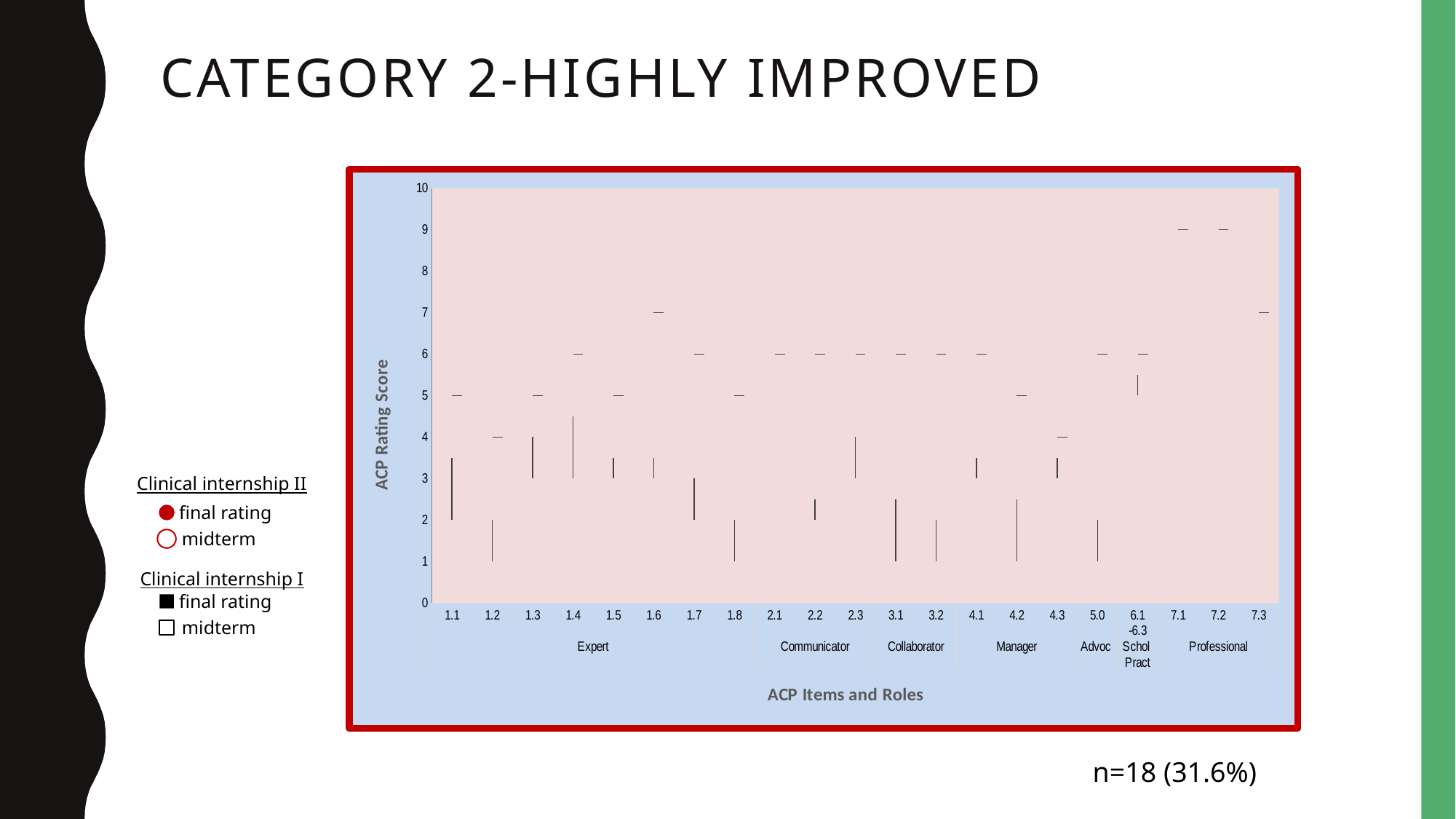
How many role groups (such as Expert, Communicator) are labelled beneath the x axis of the chart? 7 Is the lowest mark plotted for item 3.1 greater or less than 3? less Which role group covers the most ACP items on the x axis of the chart? Expert Is the highest mark plotted for item 1.6 greater or less than 6? greater What is the title of the vertical axis of the chart? ACP Rating Score What is the maximum value shown on the vertical axis of the chart? 10 What is the title of the horizontal axis of the chart? ACP Items and Roles How many ACP item categories are listed along the x axis of the chart? 21 How many ACP items fall under the Expert role group on the x axis? 8 Is the highest mark plotted for item 7.1 greater or less than 8? greater